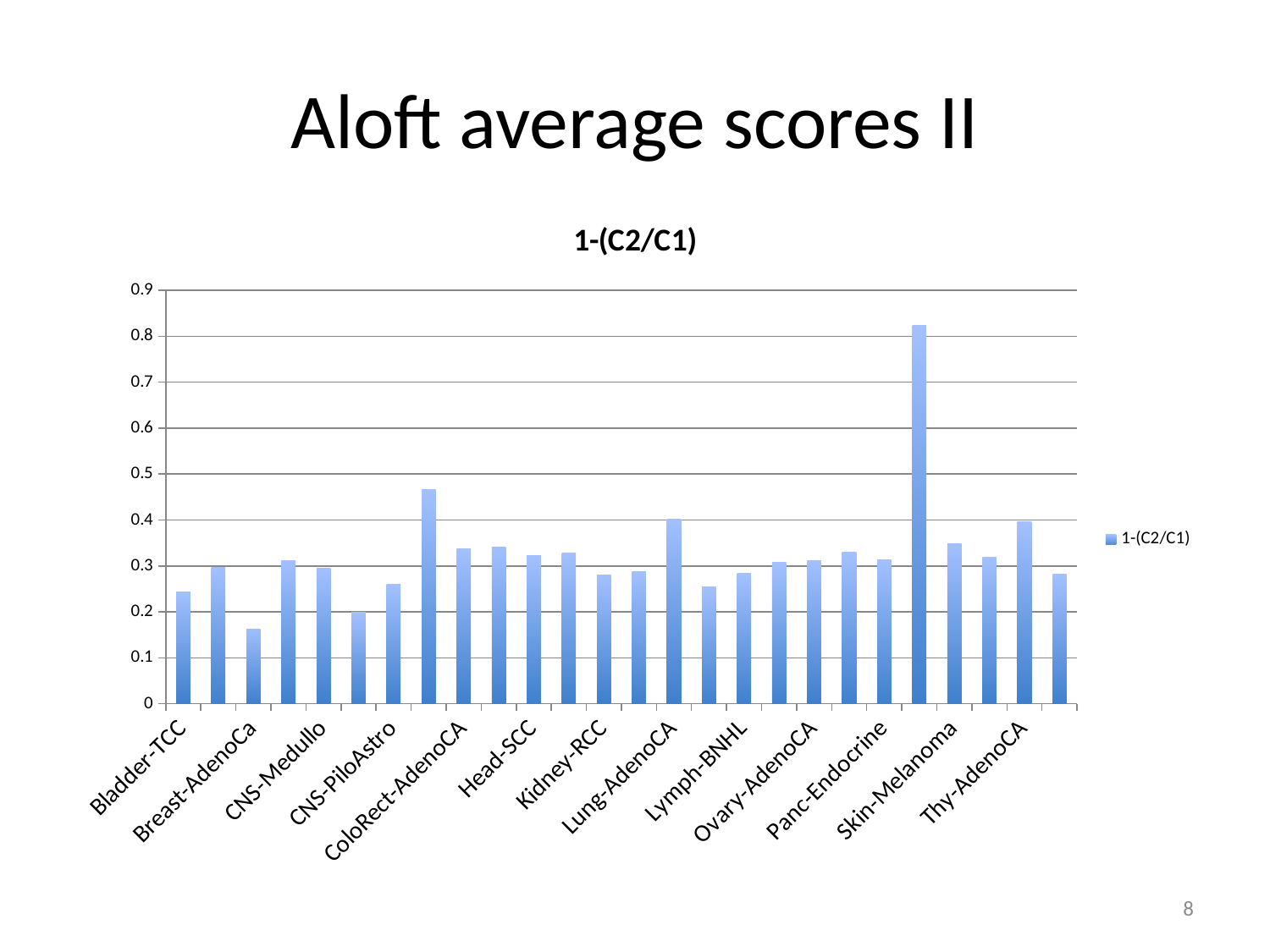
Is the value for Bladder-TCC greater or less than 0.2? greater Which is larger, the value for Bladder-TCC or the value for Breast-AdenoCa? Bladder-TCC What kind of chart is shown on the slide? bar chart How many series does the legend list? 1 Is the value for CNS-PiloAstro greater or less than 0.3? less Is the value for Breast-AdenoCa greater or less than 0.2? less What is the title of the chart? 1-(C2/C1) Which category has the lowest value in the chart? Breast-AdenoCa Which is larger, the value for Skin-Melanoma or the value for CNS-PiloAstro? Skin-Melanoma How many category labels are printed along the x axis? 13